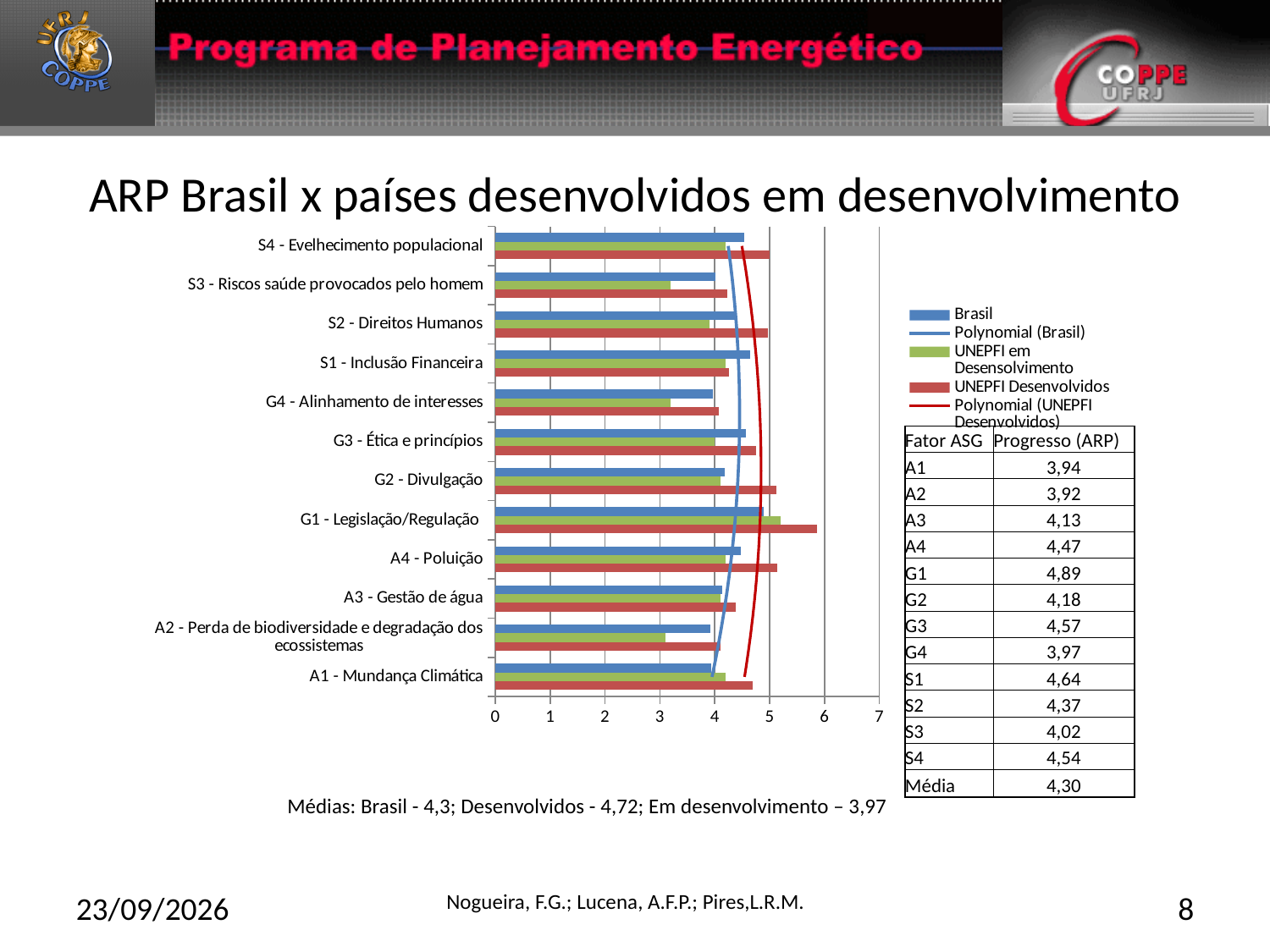
What type of chart is shown on the slide? bar chart What is the title of the slide containing the chart? ARP Brasil x países desenvolvidos em desenvolvimento Which category has the highest UNEPFI Desenvolvidos bar? G1 - Legislação/Regulação For S3 - Riscos saúde provocados pelo homem, which is larger: the Brasil bar or the UNEPFI em Desenvolvimento bar? Brasil Is the UNEPFI Desenvolvidos value for G1 - Legislação/Regulação greater or less than 5? greater How many categories are plotted on the chart? 12 What colour are the Brasil bars in the chart? blue Is the UNEPFI em Desenvolvimento value for A2 - Perda de biodiversidade e degradação dos ecossistemas greater or less than 4? less Which category has the highest Brasil bar? G1 - Legislação/Regulação For G1 - Legislação/Regulação, which is larger: the Brasil bar or the UNEPFI Desenvolvidos bar? UNEPFI Desenvolvidos How many entries does the chart legend list? 5 Is the UNEPFI em Desenvolvimento value for S3 - Riscos saúde provocados pelo homem greater or less than 4? less